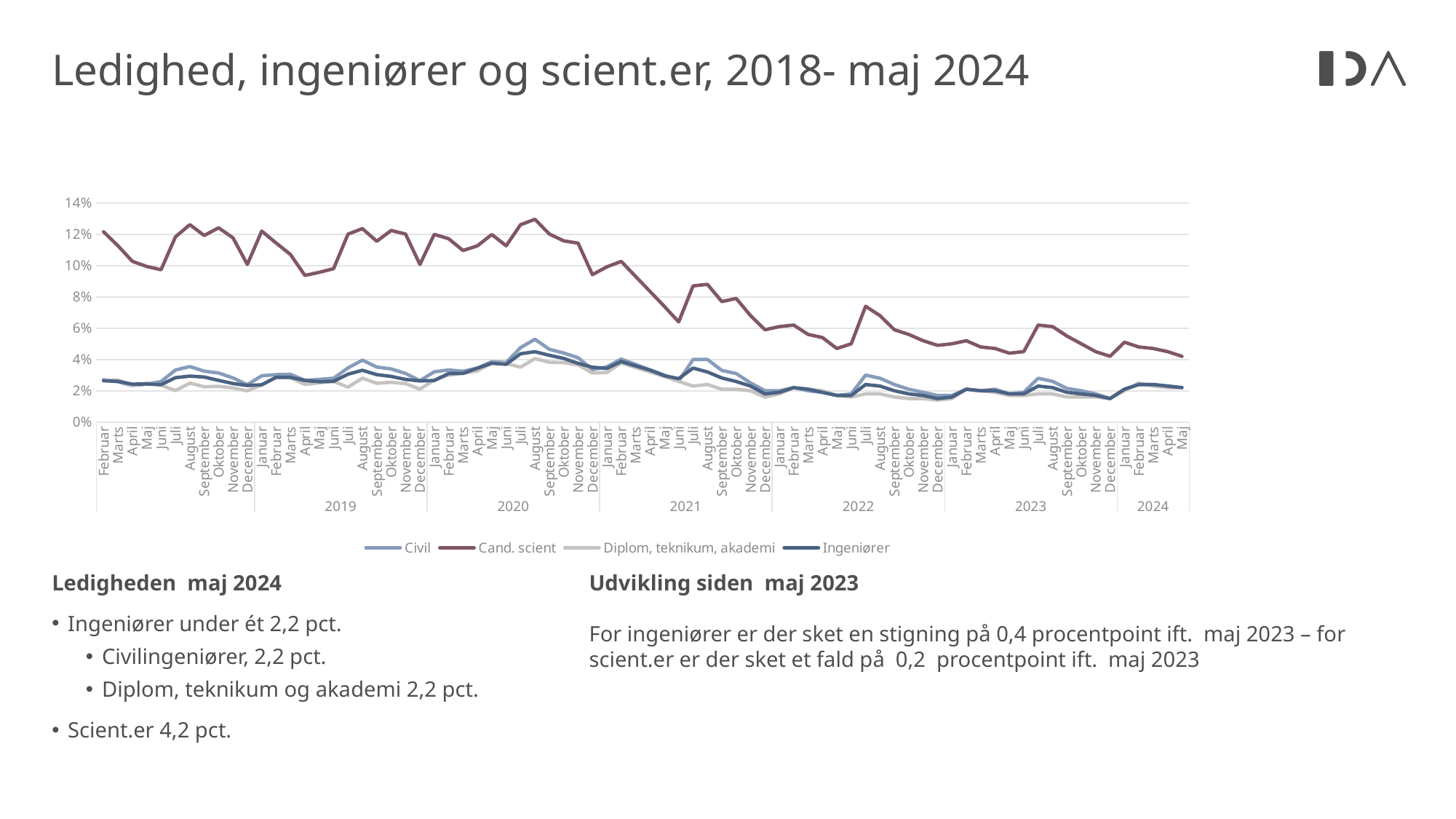
Which series is plotted highest across the whole period? Cand. scient What is the difference between the Scient.er rate and the Ingeniører rate in May 2024? 2,0 procentpoint How many series does the legend list? 4 In May 2024, which is higher: Cand. scient or Ingeniører? Cand. scient What kind of chart is shown on the slide? line chart Is the value for Cand. scient in August 2020 greater or less than 12%? greater What is the unemployment rate for Scient.er in May 2024? 4,2 pct. Does the Cand. scient line rise or fall overall from 2018 to May 2024? fall Is the value for Cand. scient in May 2024 greater or less than 6%? less Is the value for Civil in August 2020 greater or less than 4%? greater What is the unemployment rate for Ingeniører in May 2024? 2,2 pct.